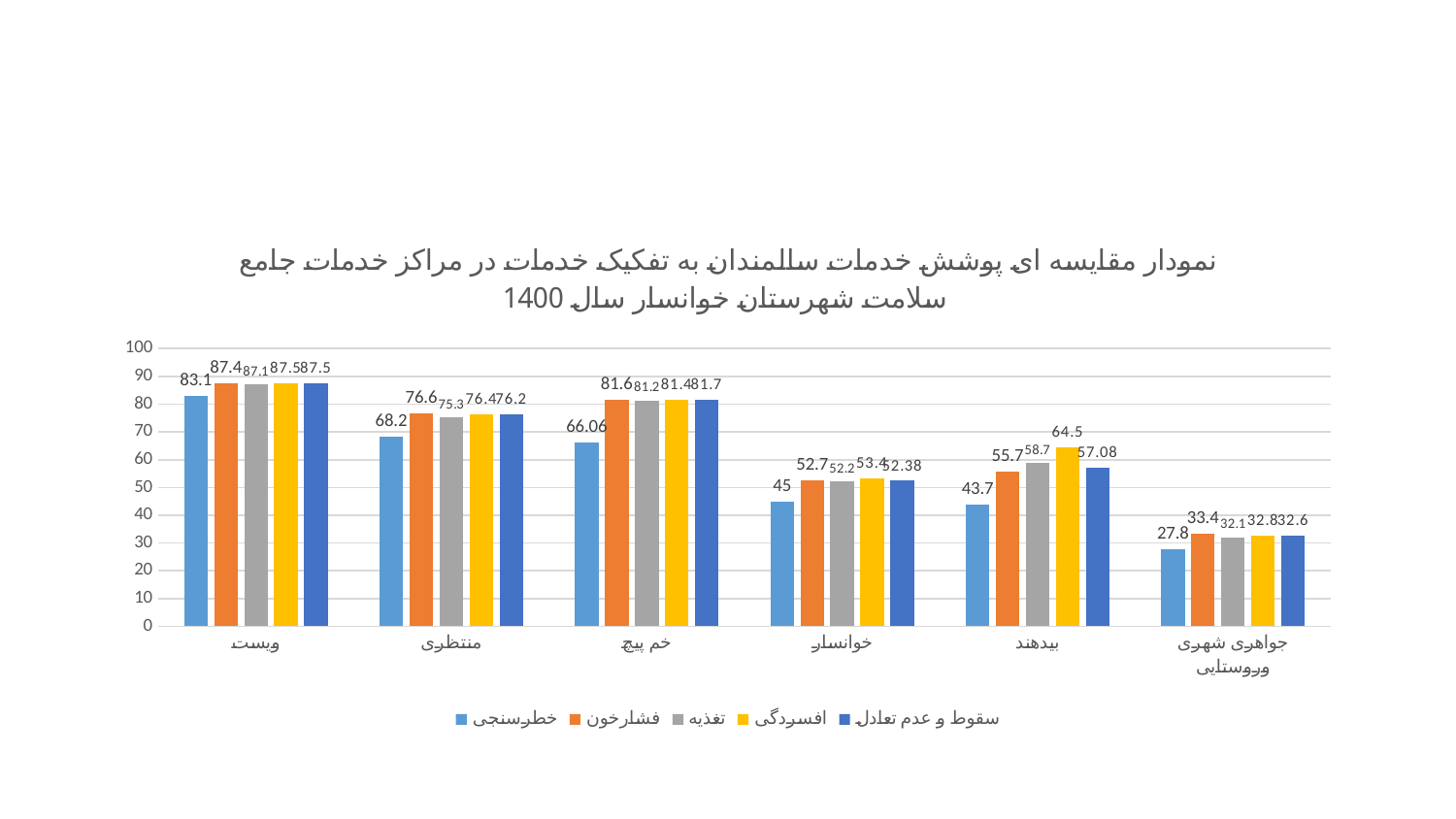
What is the value of افسردگی for بیدهند? 64.5 Which category has the highest value for فشارخون? ویست Which series is shown in yellow in the legend? افسردگی Which category has the lowest value for خطرسنجی? جواهری شهری وروستایی Which is larger for بیدهند: the تغذیه value or the فشارخون value? تغذیه How many series does the legend list? 5 What is the value of خطرسنجی for ویست? 83.1 How many categories are shown on the x axis? 6 Is the value of خطرسنجی for خوانسار greater or less than 50? less What is the difference between the فشارخون value and the خطرسنجی value for منتظری? 8.4 What is the value of خطرسنجی for خم پیچ? 66.06 What type of chart is shown on the slide? bar chart